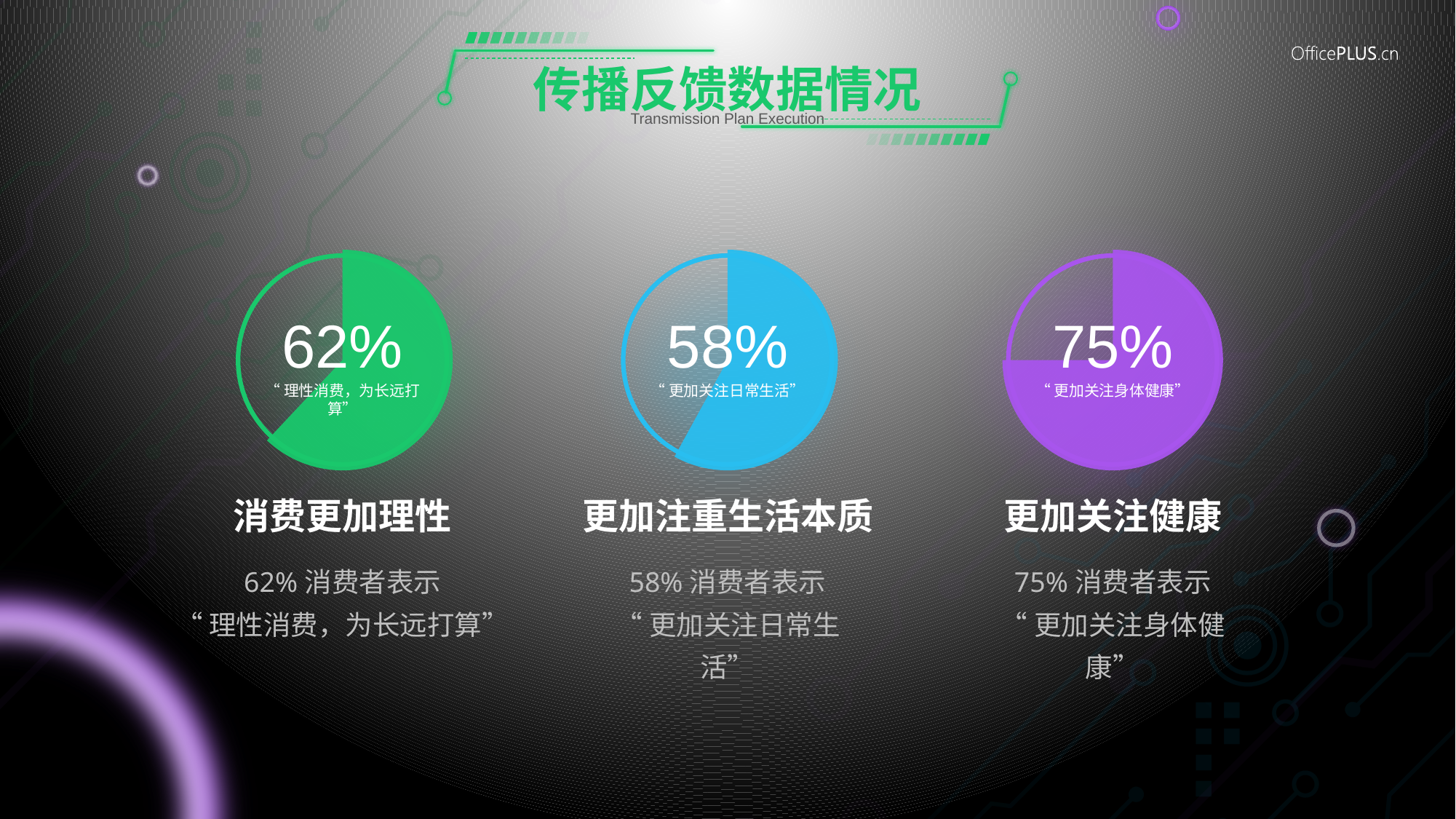
What colour is the pie chart showing 58%? blue What percentage is shown in the right (purple) pie chart? 75% Which of the three pie charts shows the lowest percentage? The middle (blue) chart, 58% How many pie charts are on the slide? 3 What is the difference between the percentage in the right pie chart and the percentage in the middle pie chart? 17% What is the difference between the percentage in the left pie chart and the percentage in the middle pie chart? 4% What percentage is shown in the middle (blue) pie chart? 58% Which of the three pie charts shows the highest percentage? The right (purple) chart, 75% What kind of chart is used to show the 62%, 58% and 75% values? pie chart What is the heading under the purple pie chart showing 75%? 更加关注健康 What percentage is shown in the left (green) pie chart? 62% Is the percentage in the left pie chart larger or smaller than the percentage in the right pie chart? smaller